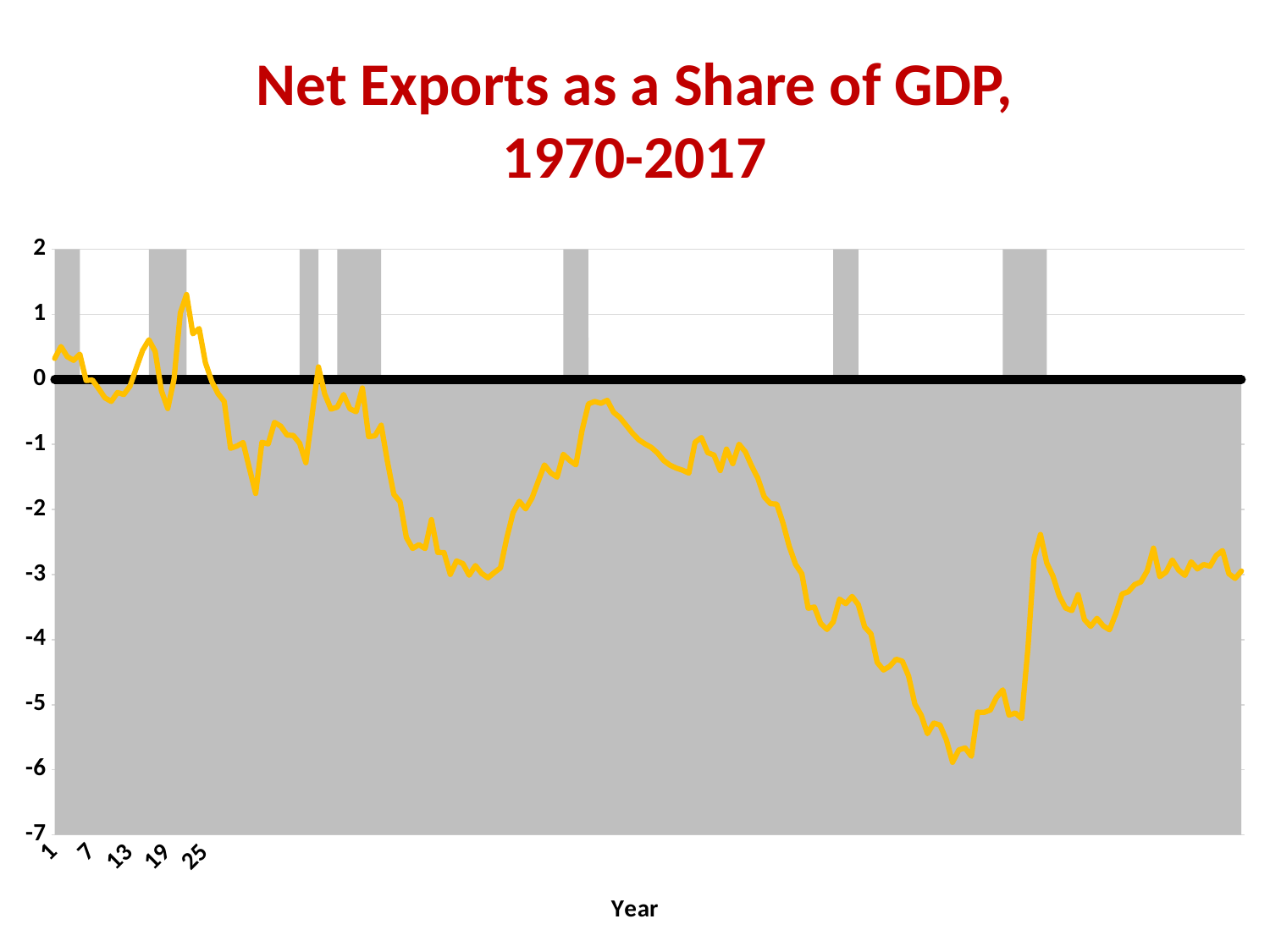
Is the net exports line above or below the zero line for most of the chart? below What is the title of the chart? Net Exports as a Share of GDP, 1970-2017 Overall, does the net exports line rise or fall from the left of the chart to the right? fall Is the value of the net exports line at the far right end of the chart greater or less than -2? less What kind of chart is shown on the slide? line chart Is the lowest point of the net exports line greater or less than -5? less Is the highest point of the net exports line greater or less than 1? greater What is the label on the horizontal axis of the chart? Year